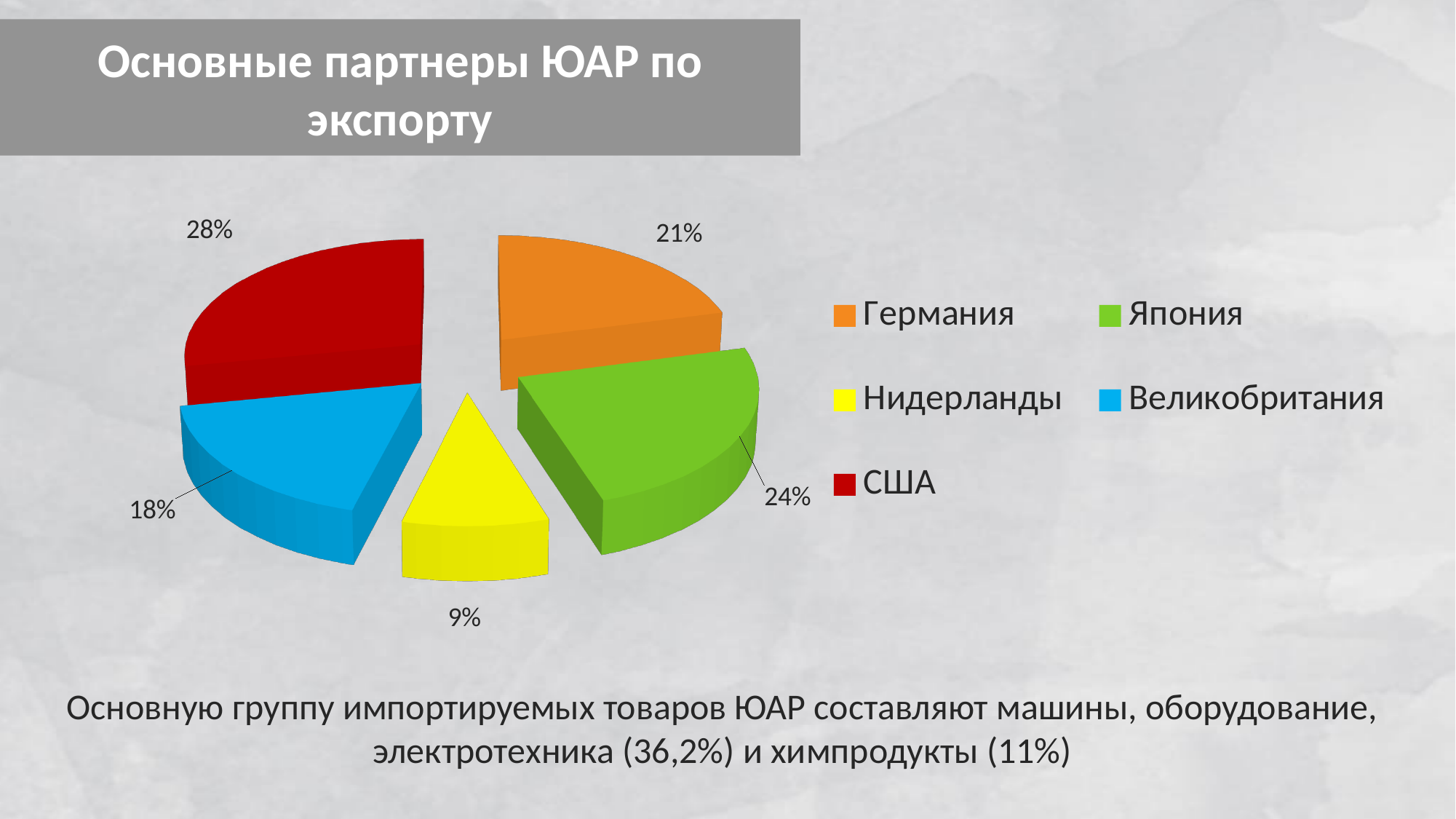
Which partner has the smallest share of the pie? Нидерланды What share of the pie does Япония have? 24% What share of the pie does Великобритания have? 18% What share of the pie does Нидерланды have? 9% What is the difference between the shares of США and Германия? 7% Which has a larger share, Япония or Великобритания? Япония What share of the pie does США have? 28% What colour is the slice for Нидерланды? Yellow How many slices does the pie chart have? 5 What type of chart is shown on the slide? Pie chart What share of the pie does Германия have? 21% Which partner has the largest share of the pie? США